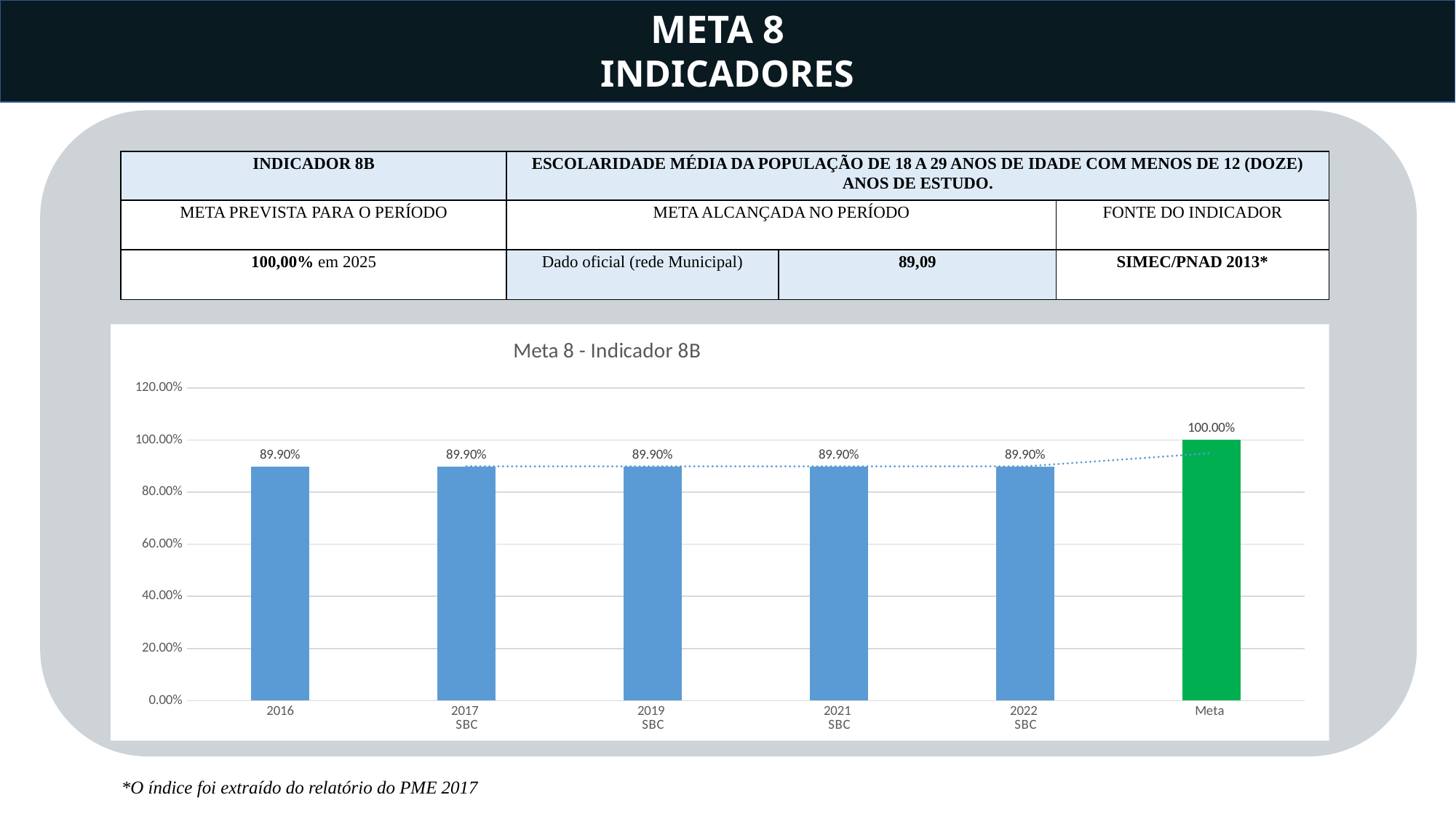
Do the values change from 2016 to 2022 SBC? No, they stay at 89.90% What is the difference between the Meta value and the 2022 SBC value? 10.10% What colour is the Meta bar? green How many bars are shown in the chart? 6 What is the value for 2022 SBC? 89.90% What is the value for 2016? 89.90% What kind of chart is shown? bar chart Which category has the highest value? Meta What is the value for Meta? 100.00% What is the title of the chart? Meta 8 - Indicador 8B Is the value for 2017 SBC greater or less than 80.00%? greater Which is larger, the value for Meta or the value for 2019 SBC? Meta